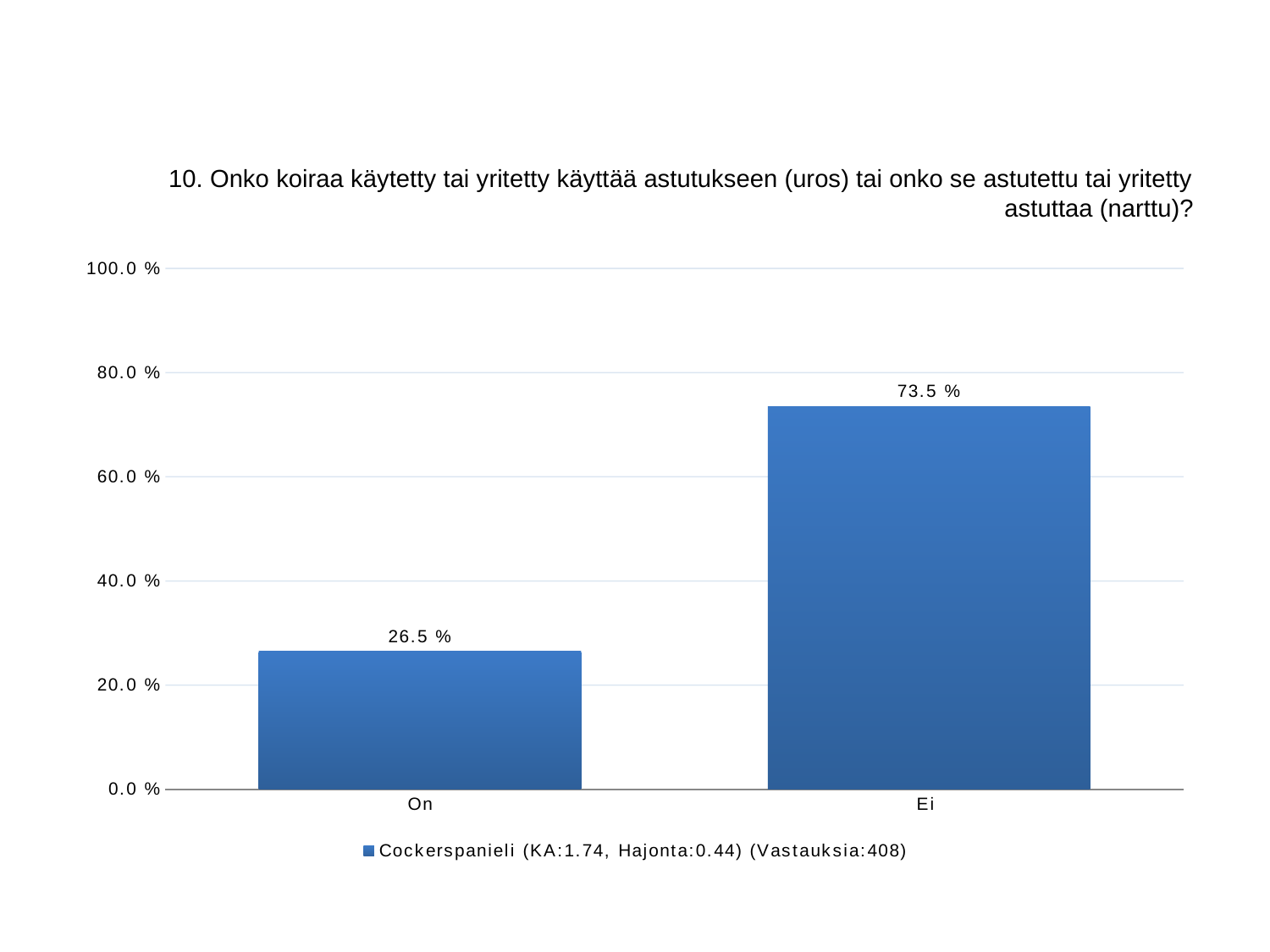
What is the difference between the values for "Ei" and "On"? 47.0 % What is the value for "On"? 26.5 % How many categories are shown on the x axis? 2 How many series does the legend list? 1 What is the value for "Ei"? 73.5 % What kind of chart is shown on the slide? bar chart Which category has the lowest value? On Is the value for "On" greater or less than 40.0 %? less Which category has the highest value? Ei Which is larger, the value for "On" or the value for "Ei"? Ei What is the legend entry for the series? Cockerspanieli (KA:1.74, Hajonta:0.44) (Vastauksia:408) Is the value for "Ei" greater or less than 60.0 %? greater